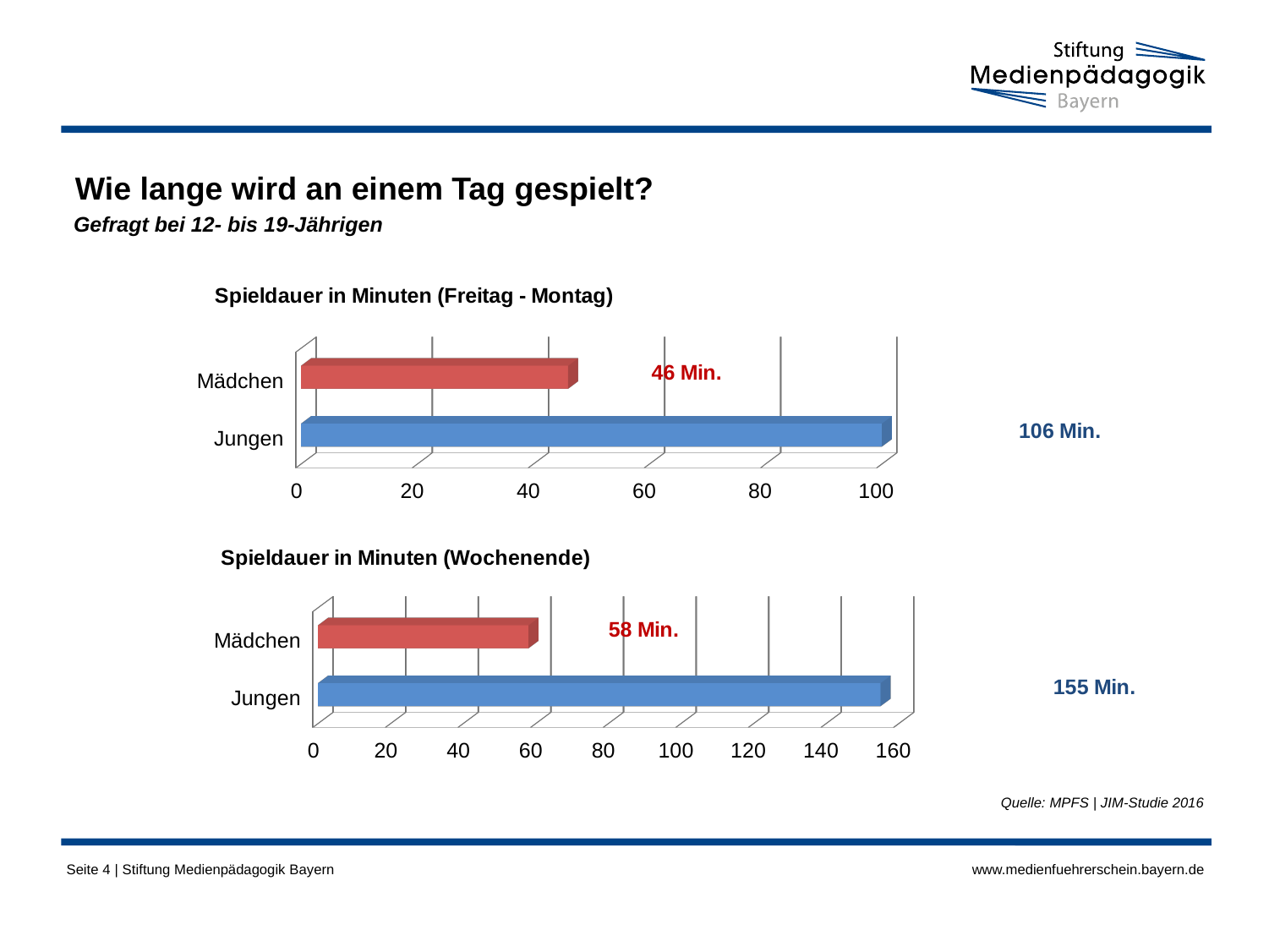
In the 'Spieldauer in Minuten (Freitag - Montag)' chart, what is the value for Jungen? 106 Min. In the 'Spieldauer in Minuten (Freitag - Montag)' chart, what colour is the bar for Mädchen? Red In the 'Spieldauer in Minuten (Freitag - Montag)' chart, what is the value for Mädchen? 46 Min. In the 'Spieldauer in Minuten (Freitag - Montag)' chart, how many categories are shown? 2 In the 'Spieldauer in Minuten (Wochenende)' chart, what is the value for Jungen? 155 Min. In the 'Spieldauer in Minuten (Wochenende)' chart, what is the value for Mädchen? 58 Min. In the 'Spieldauer in Minuten (Wochenende)' chart, which category has the lowest value? Mädchen In the 'Spieldauer in Minuten (Wochenende)' chart, is the value for Jungen greater or less than 140? greater In the 'Spieldauer in Minuten (Freitag - Montag)' chart, what is the difference between the values for Jungen and Mädchen? 60 Min. What kind of chart is the 'Spieldauer in Minuten (Wochenende)' chart? Bar chart In the 'Spieldauer in Minuten (Freitag - Montag)' chart, which category has the highest value? Jungen In the 'Spieldauer in Minuten (Wochenende)' chart, what is the difference between the values for Jungen and Mädchen? 97 Min.